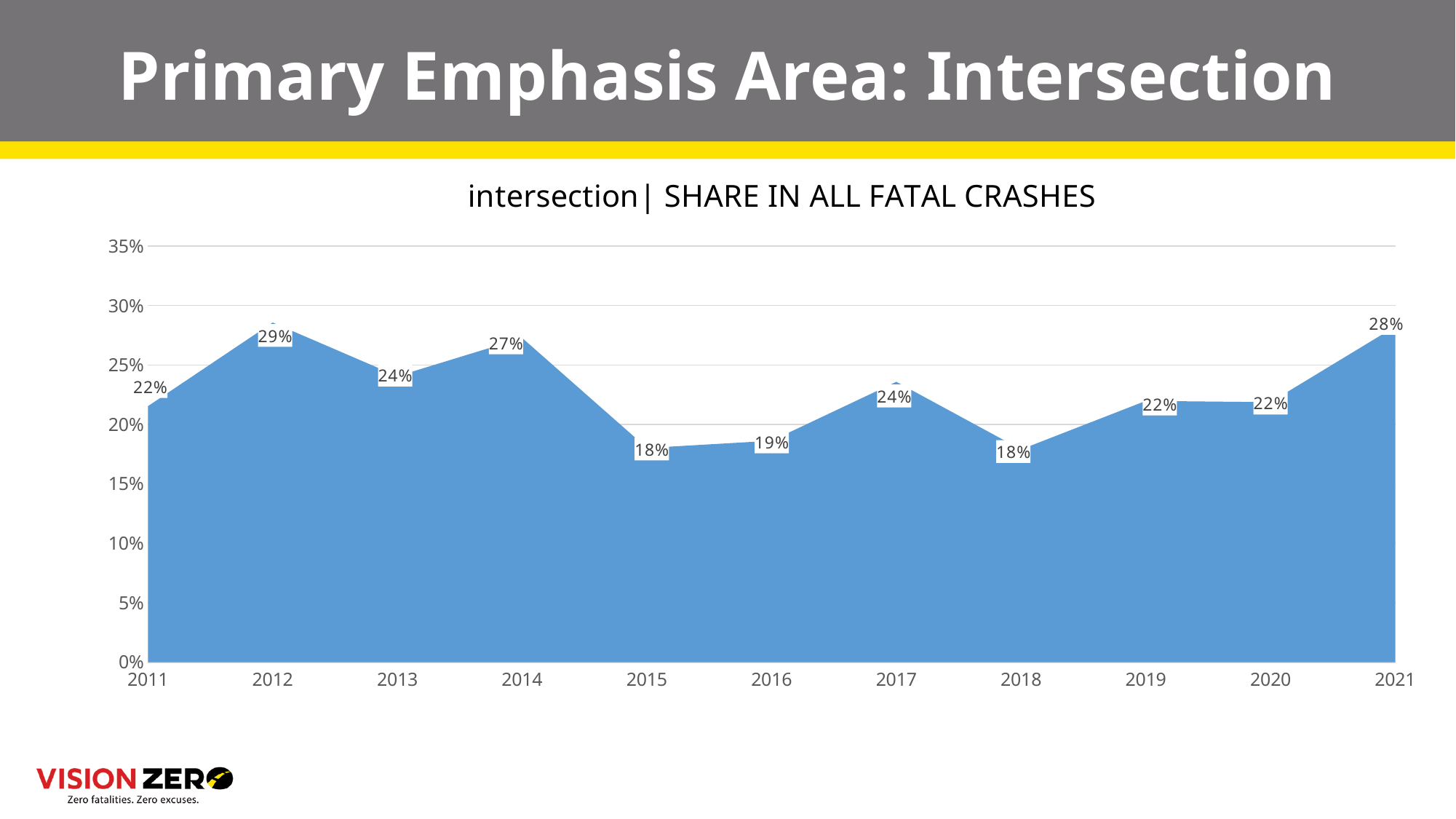
Is the value for 2014 greater or less than 25%? greater What is the difference between the 2014 value and the 2015 value? 9% What kind of chart is shown on the slide? Area chart What is the intersection share in all fatal crashes for 2012? 29% What is the lowest value shown on the chart? 18% How many years are plotted on the chart? 11 What is the title of the chart? intersection| SHARE IN ALL FATAL CRASHES Do the values rise or fall from 2018 to 2021? Rise Which is larger, the value for 2013 or the value for 2018? 2013 What is the intersection share in all fatal crashes for 2016? 19% Which year has the highest intersection share in all fatal crashes? 2012 What is the intersection share in all fatal crashes for 2021? 28%